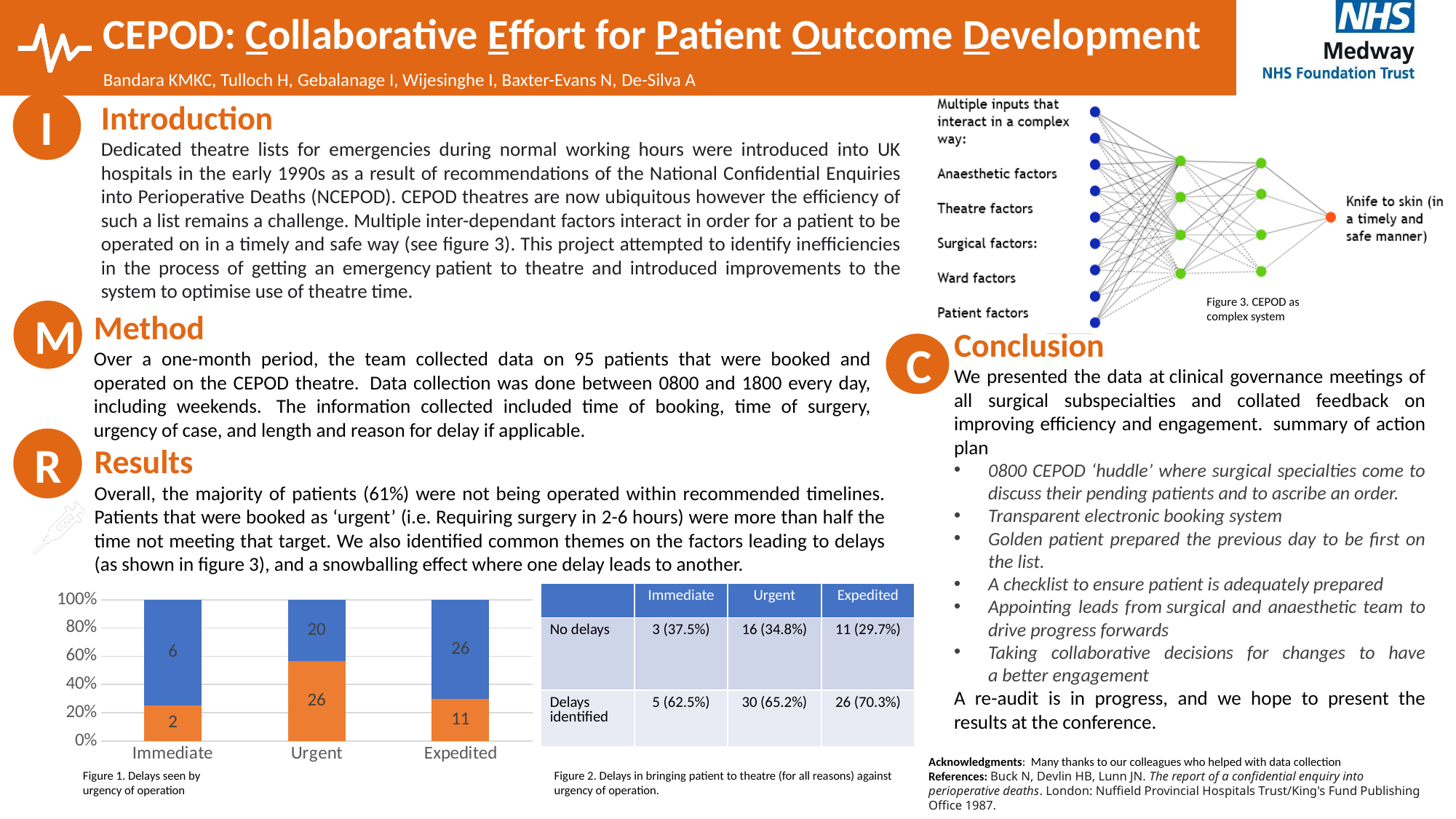
In the Figure 1 bar chart, what is the total of the two segments for Urgent? 46 In the Figure 1 bar chart, what is the value of the blue segment for Expedited? 26 What kind of chart is Figure 1 on the slide? stacked bar chart In the Figure 1 bar chart, which category has the largest orange segment value? Urgent How many categories are shown on the x axis of the Figure 1 bar chart? 3 In the Figure 1 bar chart, what is the value of the orange segment for Immediate? 2 In the Figure 1 bar chart, is the orange segment for Urgent greater or less than 40% of the bar? greater In the Figure 1 bar chart, what is the value of the orange segment for Urgent? 26 In the Figure 1 bar chart, what is the difference between the blue and orange segment values for Expedited? 15 In the Figure 1 bar chart, what is the total of the two segments for Expedited? 37 In the Figure 1 bar chart, which has the larger blue segment value, Urgent or Expedited? Expedited In the Figure 1 bar chart, what is the value of the blue segment for Immediate? 6